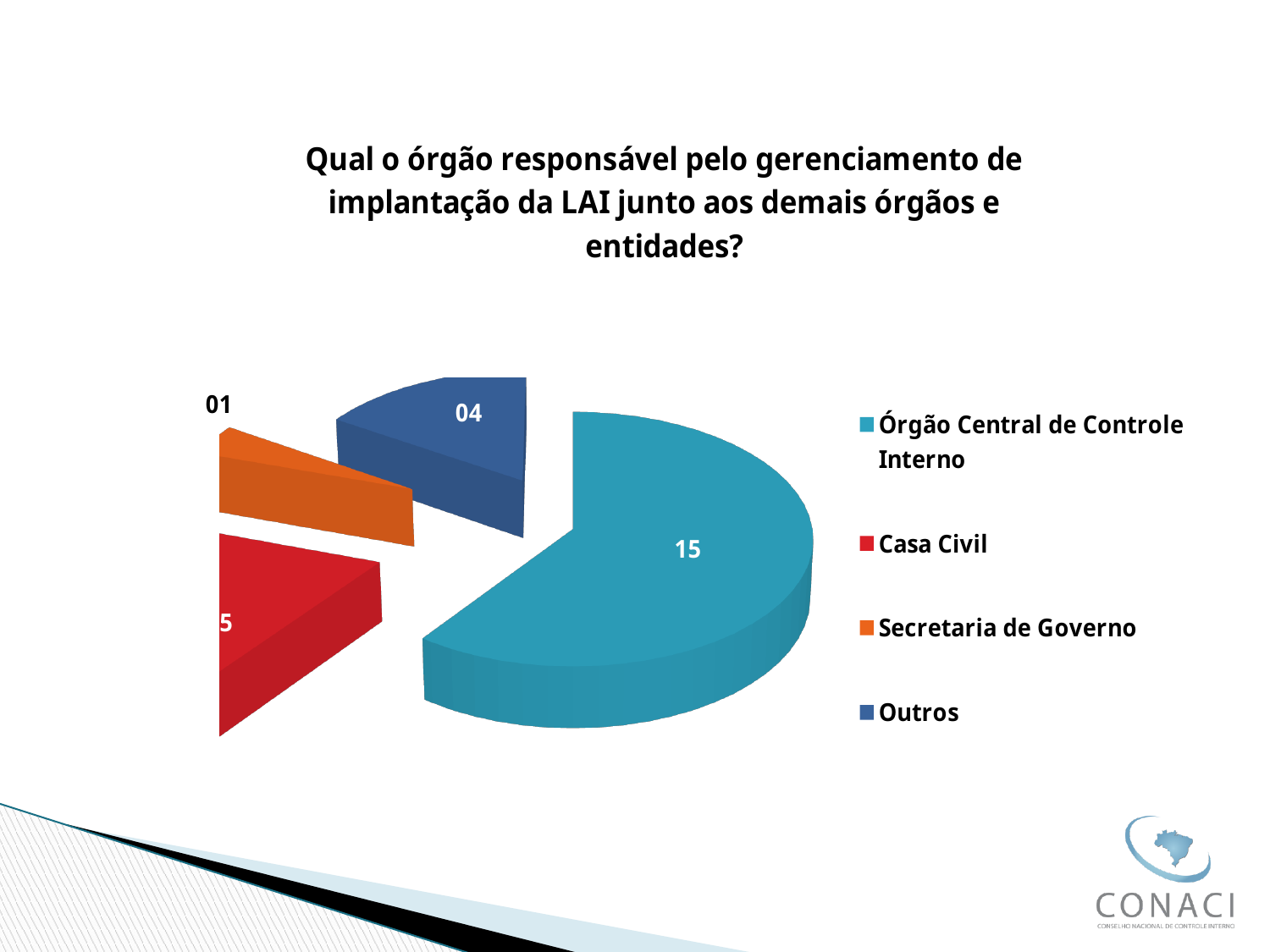
Which is larger, the value for Casa Civil or the value for Outros? Casa Civil Which category has the smallest slice? Secretaria de Governo Which is larger, the value for Outros or the value for Secretaria de Governo? Outros What colour is the slice for Casa Civil? red What kind of chart is shown on the slide? pie chart What is the value for Secretaria de Governo? 01 What is the value for Outros? 04 What is the difference between the value for Outros and the value for Secretaria de Governo? 3 How many categories does the legend list? 4 What is the difference between the value for Órgão Central de Controle Interno and the value for Outros? 11 What is the value for Órgão Central de Controle Interno? 15 Which category has the largest slice? Órgão Central de Controle Interno